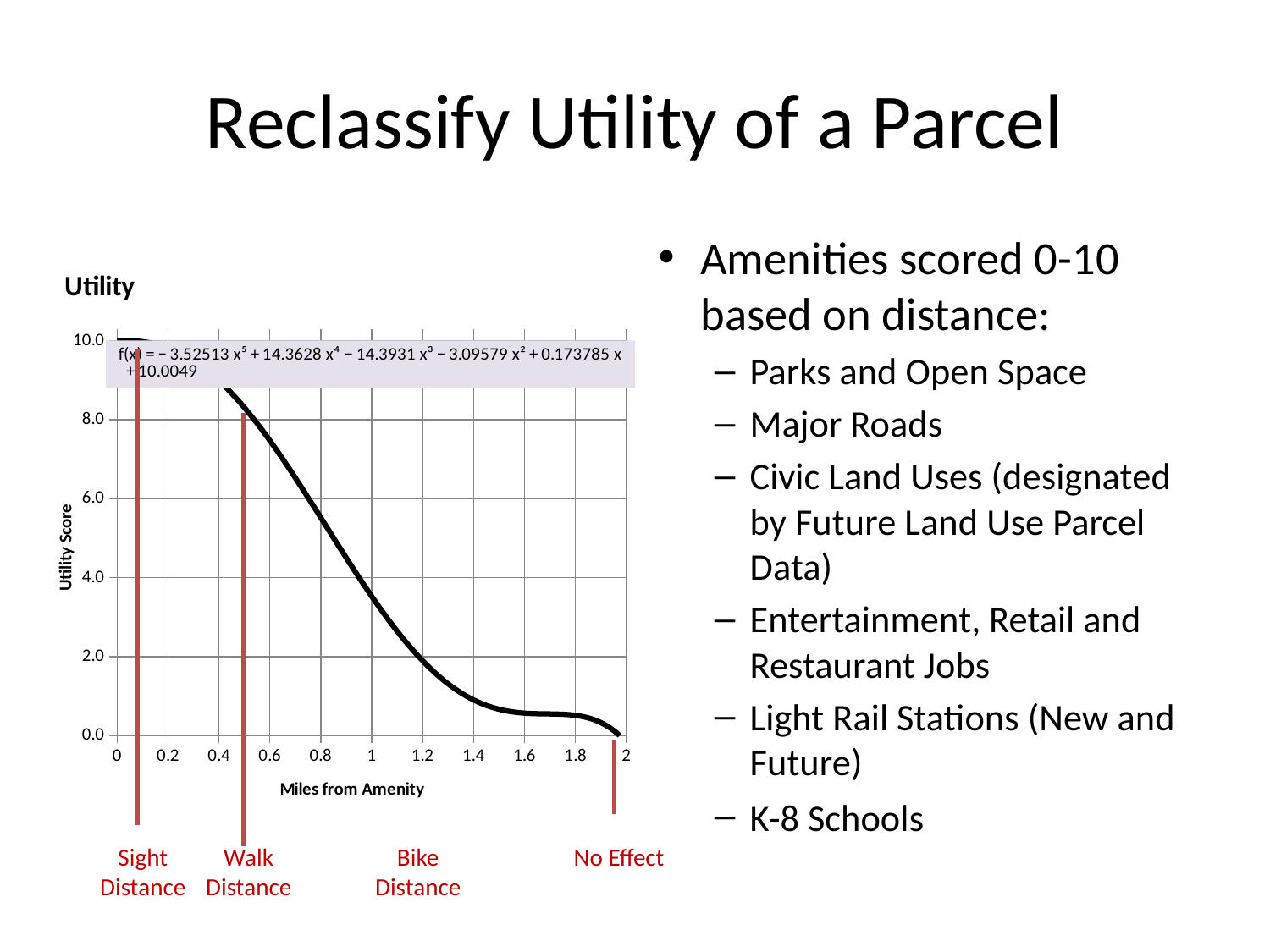
What kind of chart is shown on the slide? line chart Is the utility score at 1.8 miles from amenity greater or less than 2.0? less Is the utility score at 0.6 miles from amenity greater or less than 6.0? greater What is the label of the x axis of the chart? Miles from Amenity What is the title of the chart? Utility Is the utility score at 0.4 miles from amenity greater or less than 8.0? greater Which has the lower utility score: 0.2 miles or 1.2 miles from amenity? 1.2 miles Which has the higher utility score: 0.4 miles or 1.4 miles from amenity? 0.4 miles Does the utility score rise or fall as miles from amenity increase? fall At what distance in miles from amenity is the utility score highest? 0